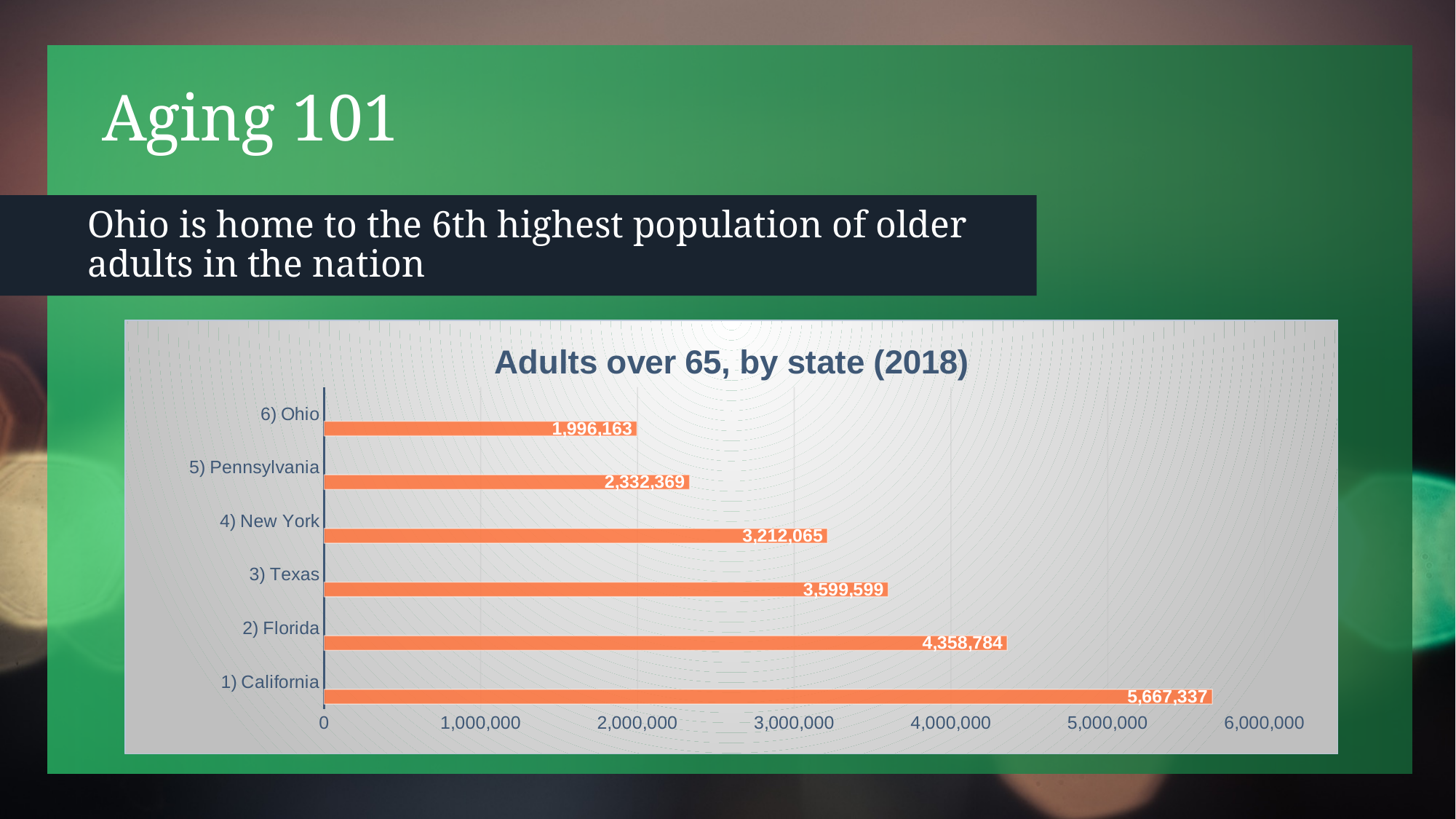
Is the value for Ohio greater or less than 2,000,000? less Which is larger, the value for Pennsylvania or the value for Texas? Texas What kind of chart is shown on the slide? bar chart What is the value for Florida in the chart? 4,358,784 What is the difference between the values for California and Florida? 1,308,553 What is the value for New York in the chart? 3,212,065 What is the difference between the values for Texas and New York? 387,534 What is the title of the chart? Adults over 65, by state (2018) How many states are shown in the chart? 6 What is the value for Ohio in the chart? 1,996,163 Which state has the highest number of adults over 65 in the chart? California Which state has the lowest number of adults over 65 in the chart? Ohio